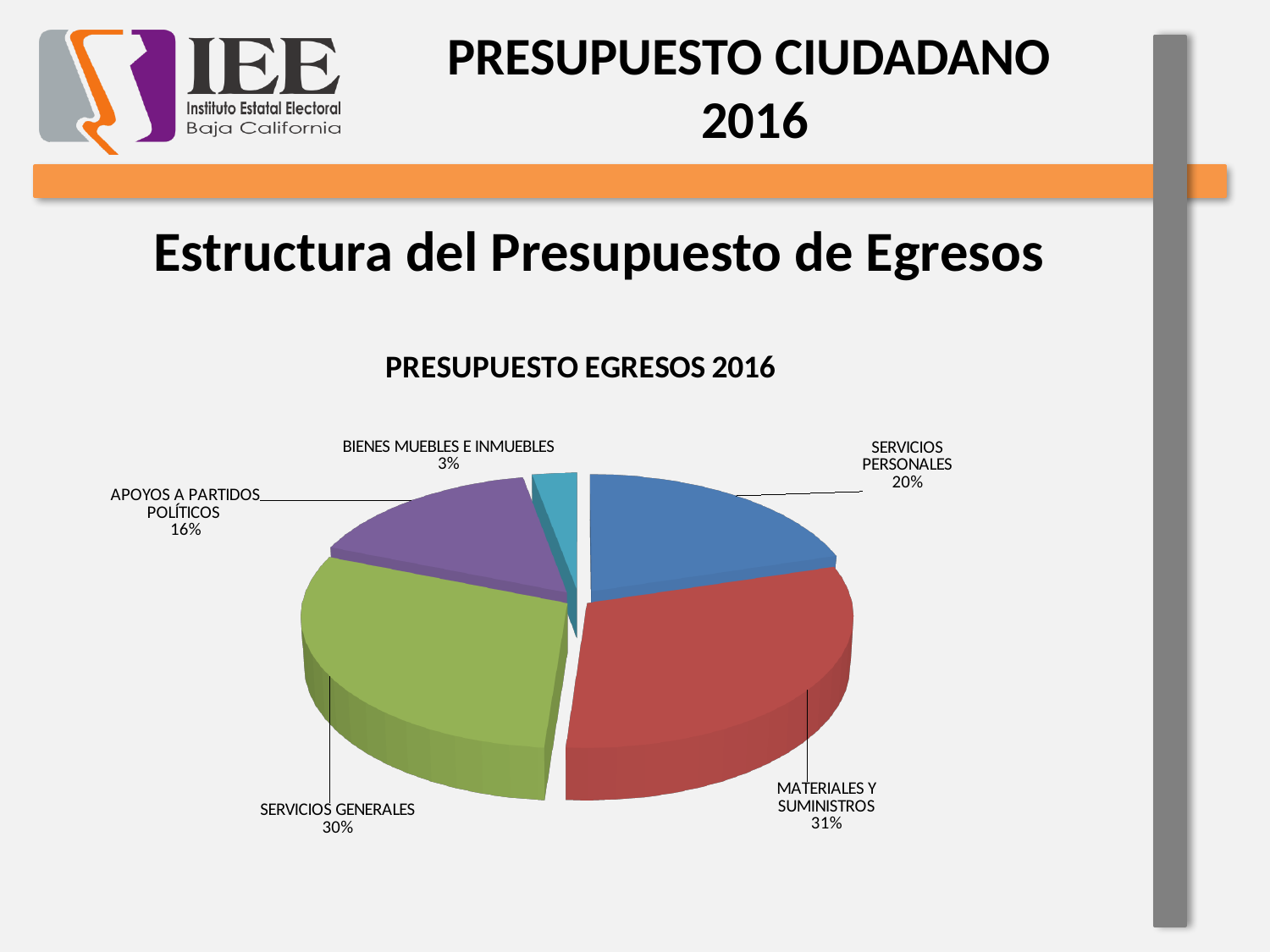
What type of chart is shown on the slide? Pie chart How many categories are shown in the pie chart? 5 What is the title of the chart? PRESUPUESTO EGRESOS 2016 What is the difference in percentage points between SERVICIOS PERSONALES and APOYOS A PARTIDOS POLÍTICOS? 4 What percentage of the budget goes to SERVICIOS PERSONALES? 20% Which is larger, the share for SERVICIOS PERSONALES or the share for SERVICIOS GENERALES? SERVICIOS GENERALES What percentage of the budget goes to SERVICIOS GENERALES? 30% Which category has the largest share of the budget? MATERIALES Y SUMINISTROS What percentage of the budget goes to MATERIALES Y SUMINISTROS? 31% What percentage of the budget goes to BIENES MUEBLES E INMUEBLES? 3% What percentage of the budget goes to APOYOS A PARTIDOS POLÍTICOS? 16% Which category has the smallest share of the budget? BIENES MUEBLES E INMUEBLES